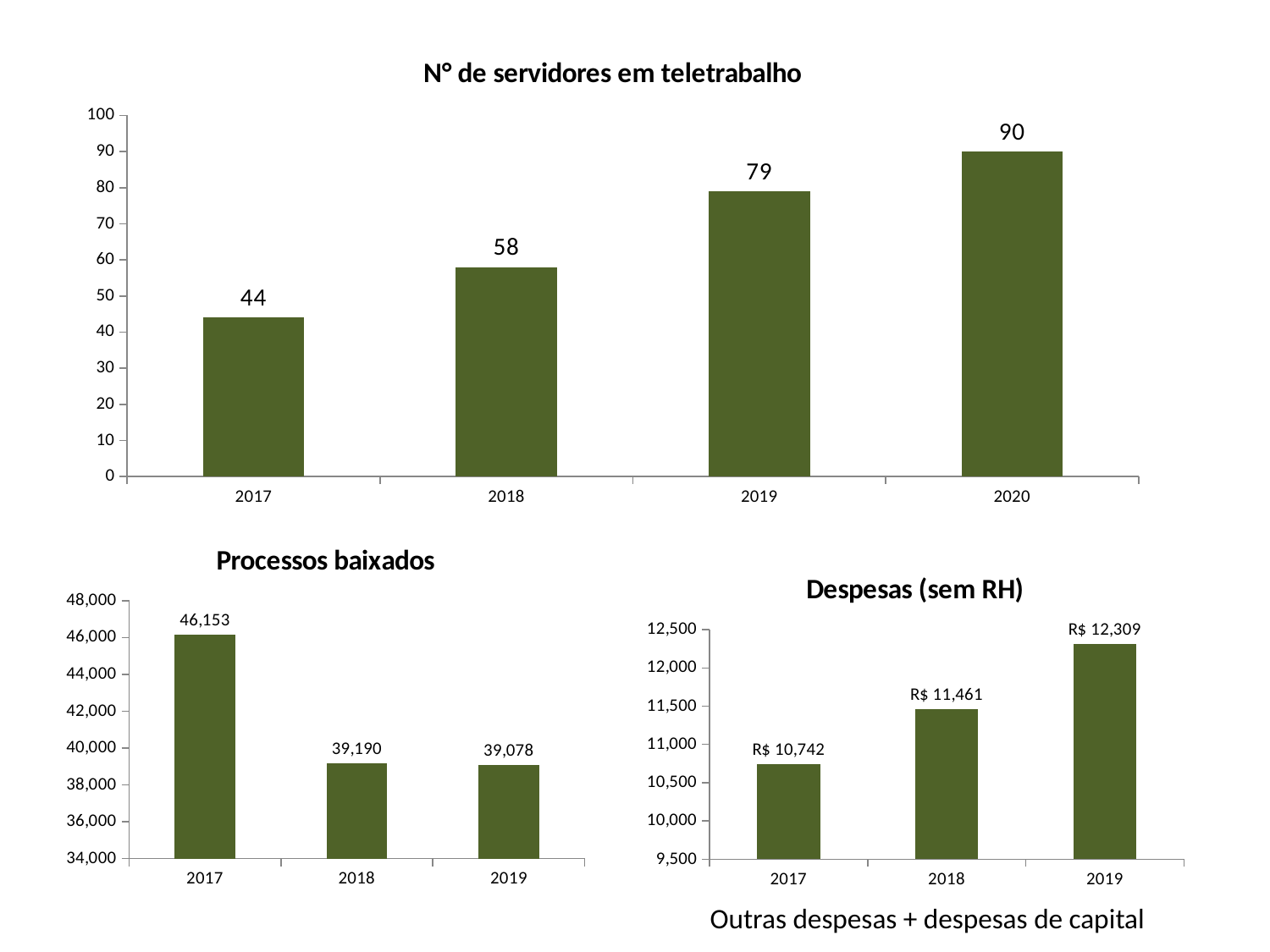
In the 'Nº de servidores em teletrabalho' chart, do the values rise or fall from 2017 to 2020? rise What text appears below the 'Despesas (sem RH)' chart? Outras despesas + despesas de capital In the 'Nº de servidores em teletrabalho' chart, which year has the highest value? 2020 In the 'Nº de servidores em teletrabalho' chart, what is the difference between the 2020 and 2017 values? 46 What kind of chart is 'Despesas (sem RH)'? bar chart In the 'Processos baixados' chart, what is the value for 2017? 46,153 In the 'Nº de servidores em teletrabalho' chart, what is the value for 2019? 79 In the 'Processos baixados' chart, what is the difference between the 2017 and 2018 values? 6,963 How many years are shown in the 'Nº de servidores em teletrabalho' chart? 4 In the 'Despesas (sem RH)' chart, which is larger, the value for 2017 or the value for 2019? 2019 In the 'Despesas (sem RH)' chart, what is the value for 2018? R$ 11,461 In the 'Processos baixados' chart, which year has the lowest value? 2019